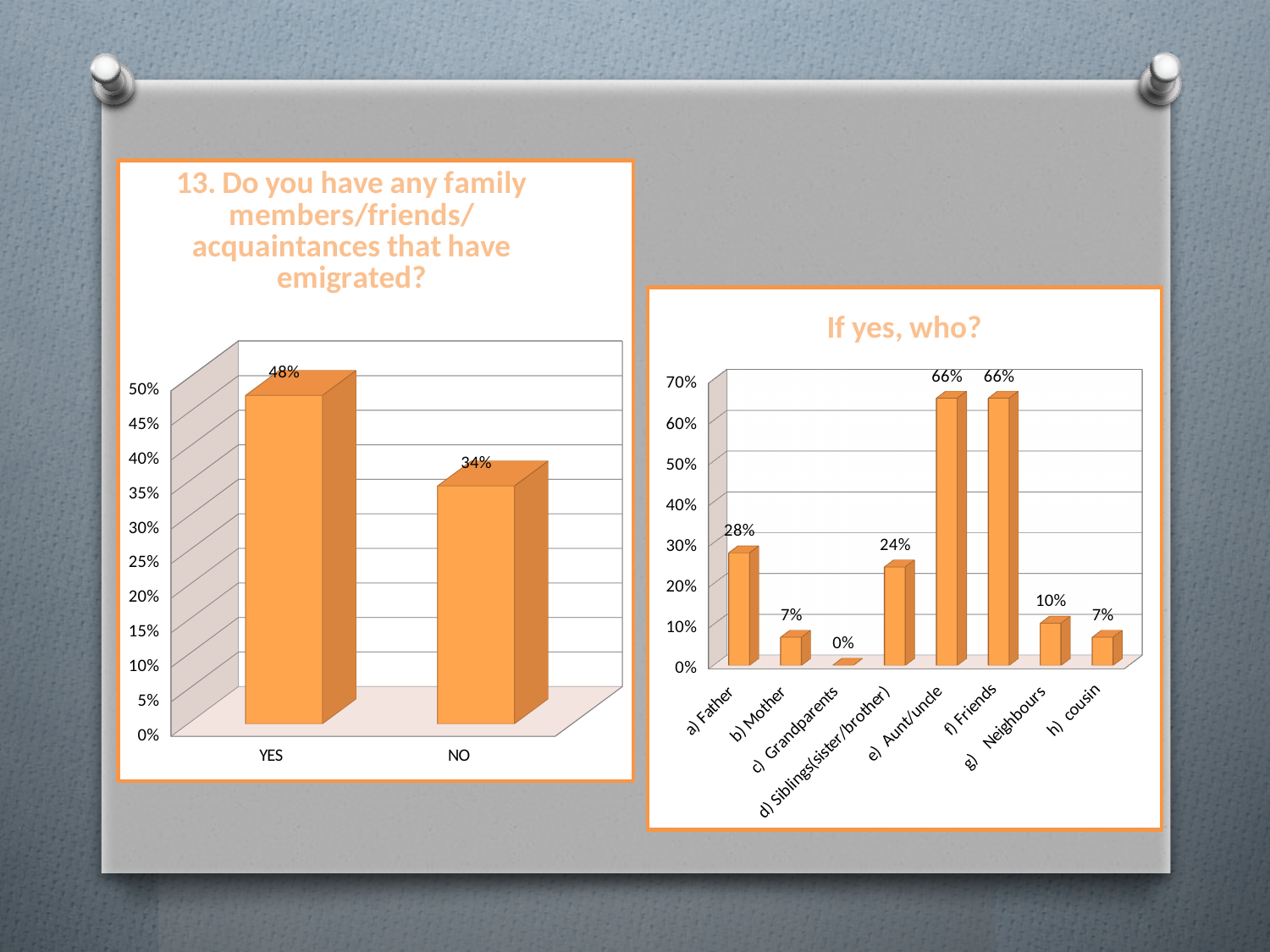
In the 'If yes, who?' chart, which category has the lowest value? c) Grandparents In the left chart (question 13), what is the value for YES? 48% In the left chart (question 13), how many categories are shown? 2 In the 'If yes, who?' chart, what is the difference between e) Aunt/uncle and b) Mother? 59% In the 'If yes, who?' chart, which is larger, a) Father or d) Siblings(sister/brother)? a) Father In the left chart (question 13), what is the difference between the YES and NO values? 14% In the 'If yes, who?' chart, how many categories are shown? 8 In the 'If yes, who?' chart, what is the value for d) Siblings(sister/brother)? 24% In the 'If yes, who?' chart, what is the value for g) Neighbours? 10% In the left chart (question 13), what is the value for NO? 34% What kind of chart is the 'If yes, who?' chart? Bar chart In the 'If yes, who?' chart, what is the value for a) Father? 28%